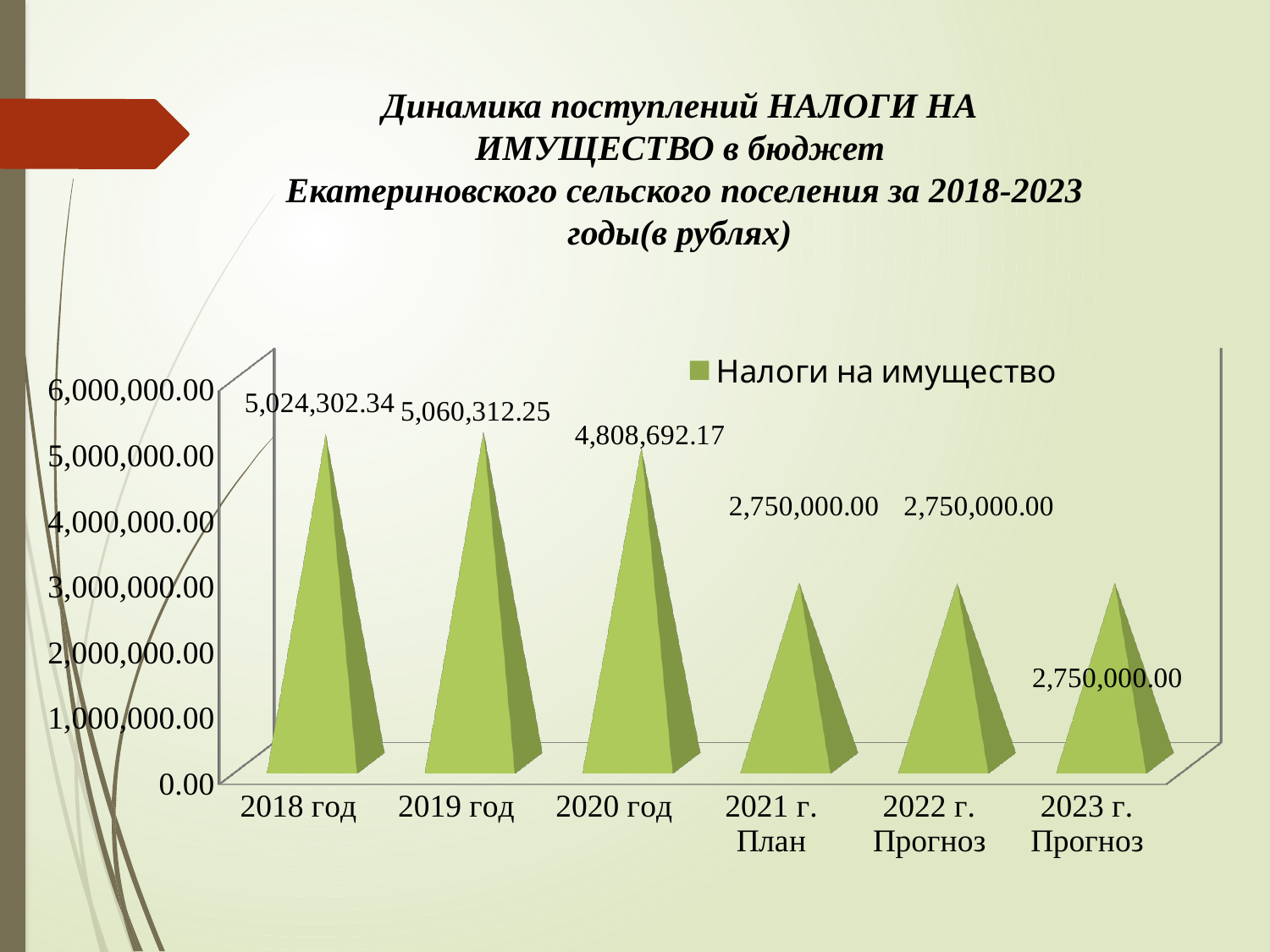
What is the value for 2020 год? 4,808,692.17 How many series does the legend list? 1 Is the value for 2022 г. Прогноз greater or less than 3,000,000.00? less What is the value for 2018 год? 5,024,302.34 What kind of chart is shown on the slide? bar chart Which is larger, the value for 2018 год or the value for 2020 год? 2018 год What is the value for 2021 г. План? 2,750,000.00 What is the name of the series shown in the legend? Налоги на имущество Which year has the highest value? 2019 год How many categories are shown on the x axis? 6 What is the difference between the values for 2020 год and 2021 г. План? 2,058,692.17 What is the difference between the values for 2019 год and 2018 год? 36,009.91